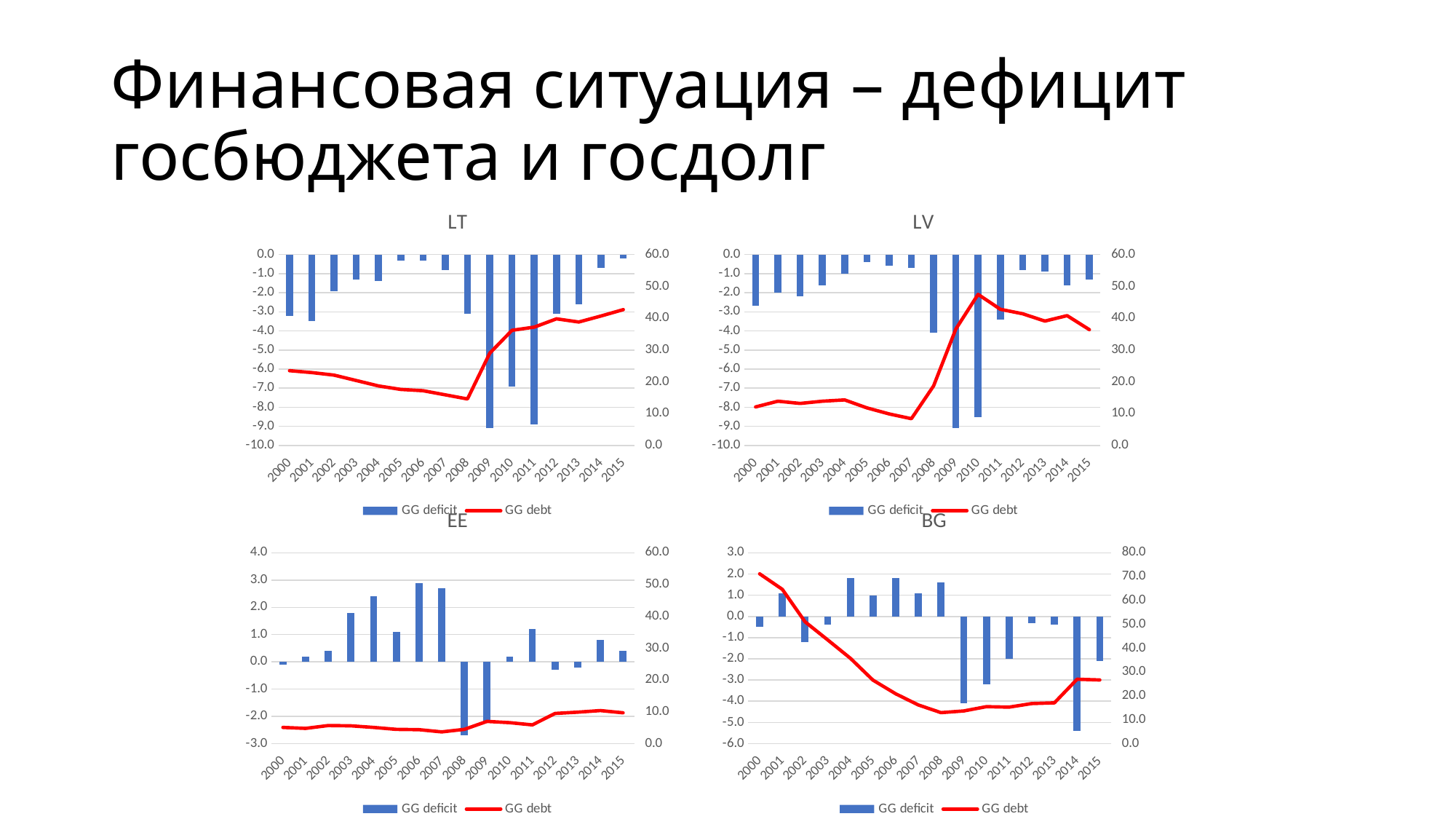
In the BG chart, which year has the lowest GG deficit bar? 2014 What kind of chart is the BG chart? Combined bar and line chart In the BG chart, is the GG debt value for 2000 greater or less than 60.0? greater In the LV chart, what are the two legend entries? GG deficit, GG debt In the EE chart, how many years are shown on the x axis? 16 How many charts are on the slide? 4 In the LV chart, is the GG debt value for 2010 greater or less than 40.0? greater In the LT chart, how many series does the legend list? 2 In the LT chart, does the GG debt line rise or fall from 2008 to 2015? rise In the LT chart, which year has the lower GG deficit bar, 2010 or 2012? 2010 In the BG chart, does the GG debt line rise or fall from 2000 to 2008? fall In the EE chart, which year has the lowest GG deficit bar? 2008